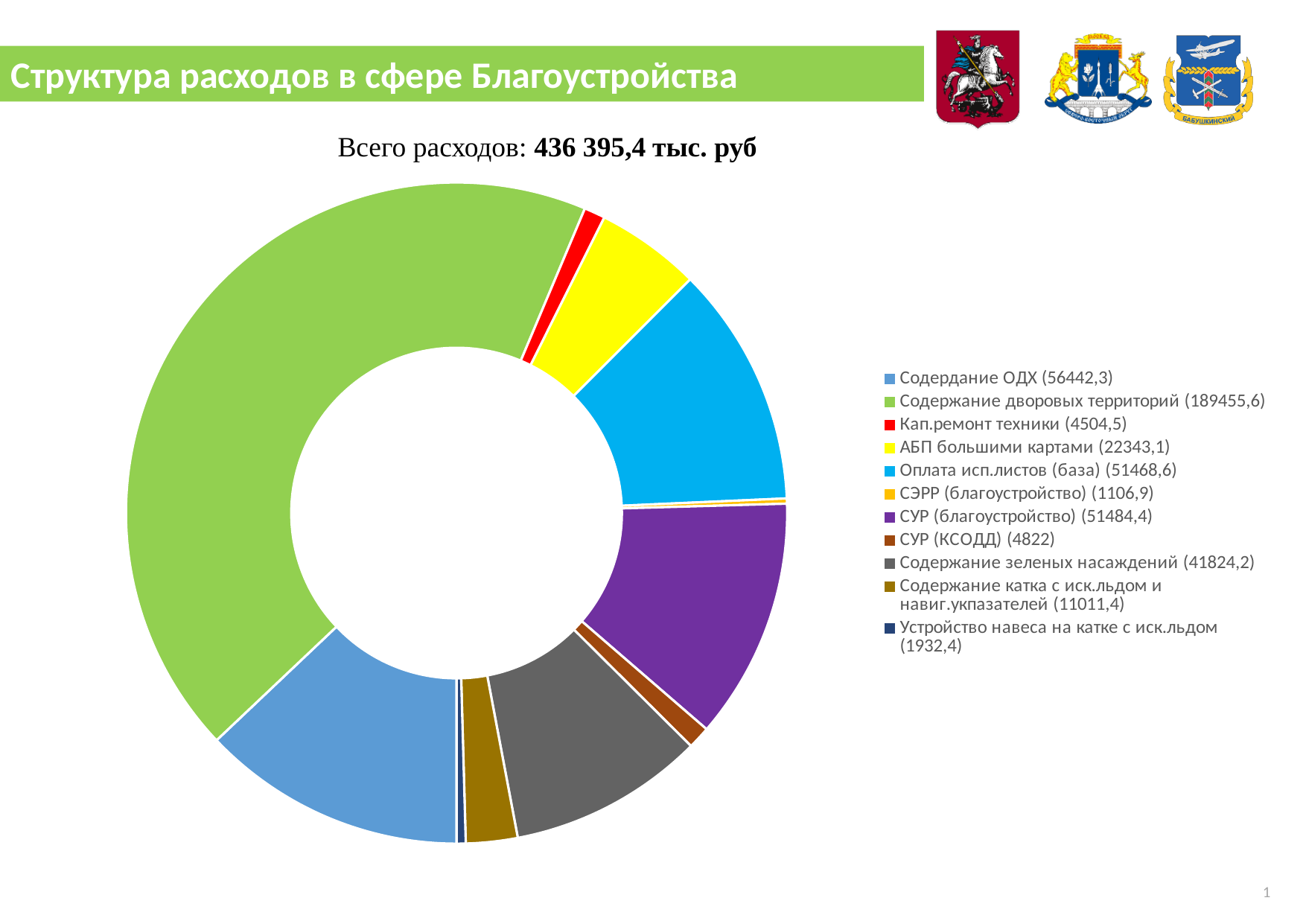
What is the value for Устройство навеса на катке с иск.льдом? 1932,4 What is the value for Содержание дворовых территорий? 189455,6 What is the difference between АБП большими картами and Кап.ремонт техники? 17838,6 What is the total of all expenses shown above the chart? 436 395,4 тыс. руб What is the difference between Содержание ОДХ and Оплата исп.листов (база)? 4973,7 What kind of chart is shown on the slide? doughnut chart What is the value for Оплата исп.листов (база)? 51468,6 Which category has the smallest value? СЭРР (благоустройство) Which is larger: Содержание ОДХ or Содержание зеленых насаждений? Содержание ОДХ What is the value for Содержание зеленых насаждений? 41824,2 How many categories does the chart show? 11 Which category has the largest share of expenses? Содержание дворовых территорий